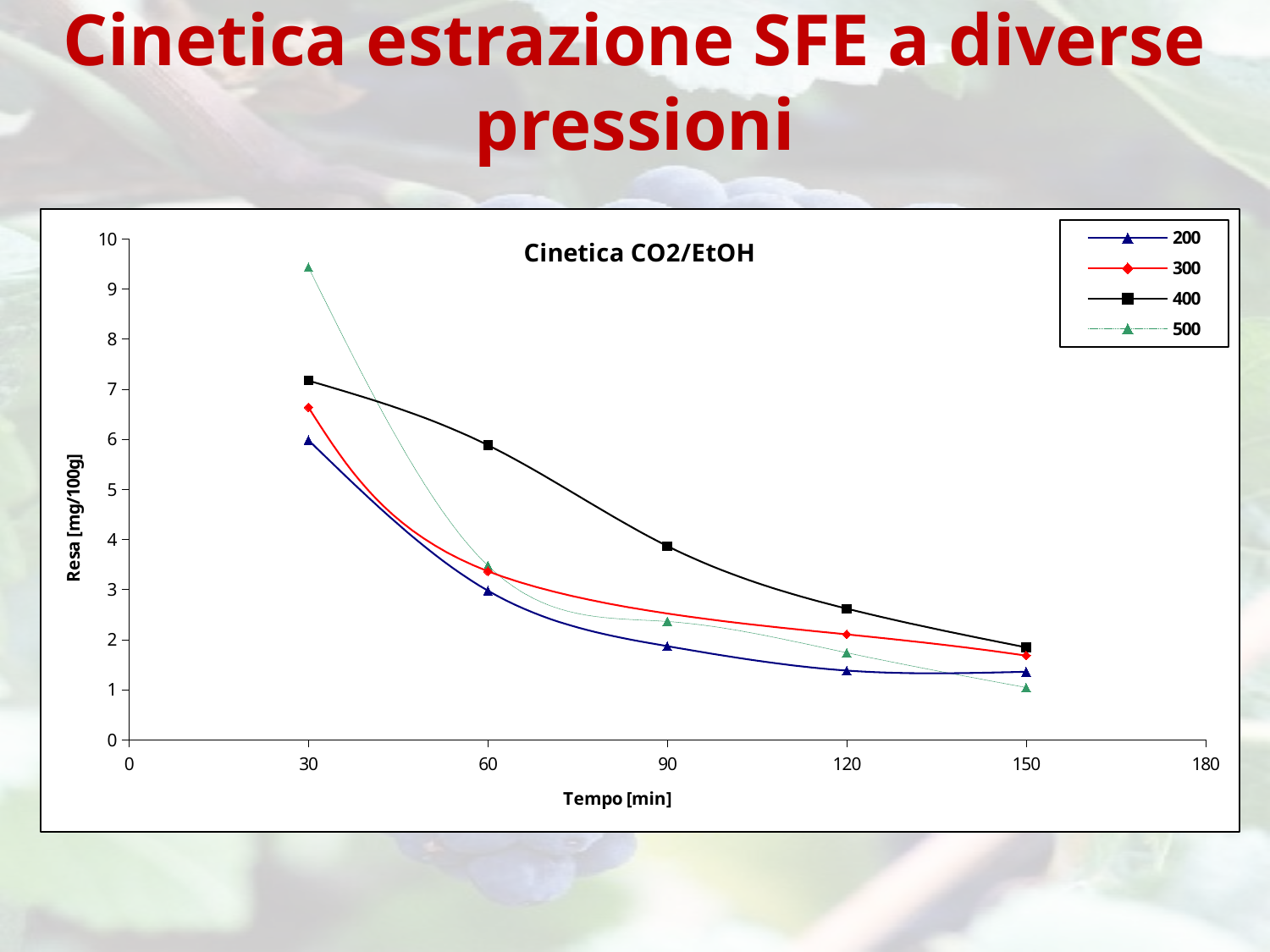
Is the value for the 400 series at 60 min greater or less than 5? greater How many series does the legend list? 4 Which series has the highest value at 30 min? 500 At 90 min, which series has the larger value, 400 or 200? 400 Is the value for the 500 series at 30 min greater or less than 9? greater What is the title of the chart? Cinetica CO2/EtOH Do the values of the 400 series rise or fall as time increases along the x axis? fall Which series has the lowest value at 150 min? 500 How many time points are plotted for the 400 series? 5 Which series has the lowest value at 30 min? 200 What kind of chart is shown on the slide? line chart Which series has the highest value at 150 min? 400